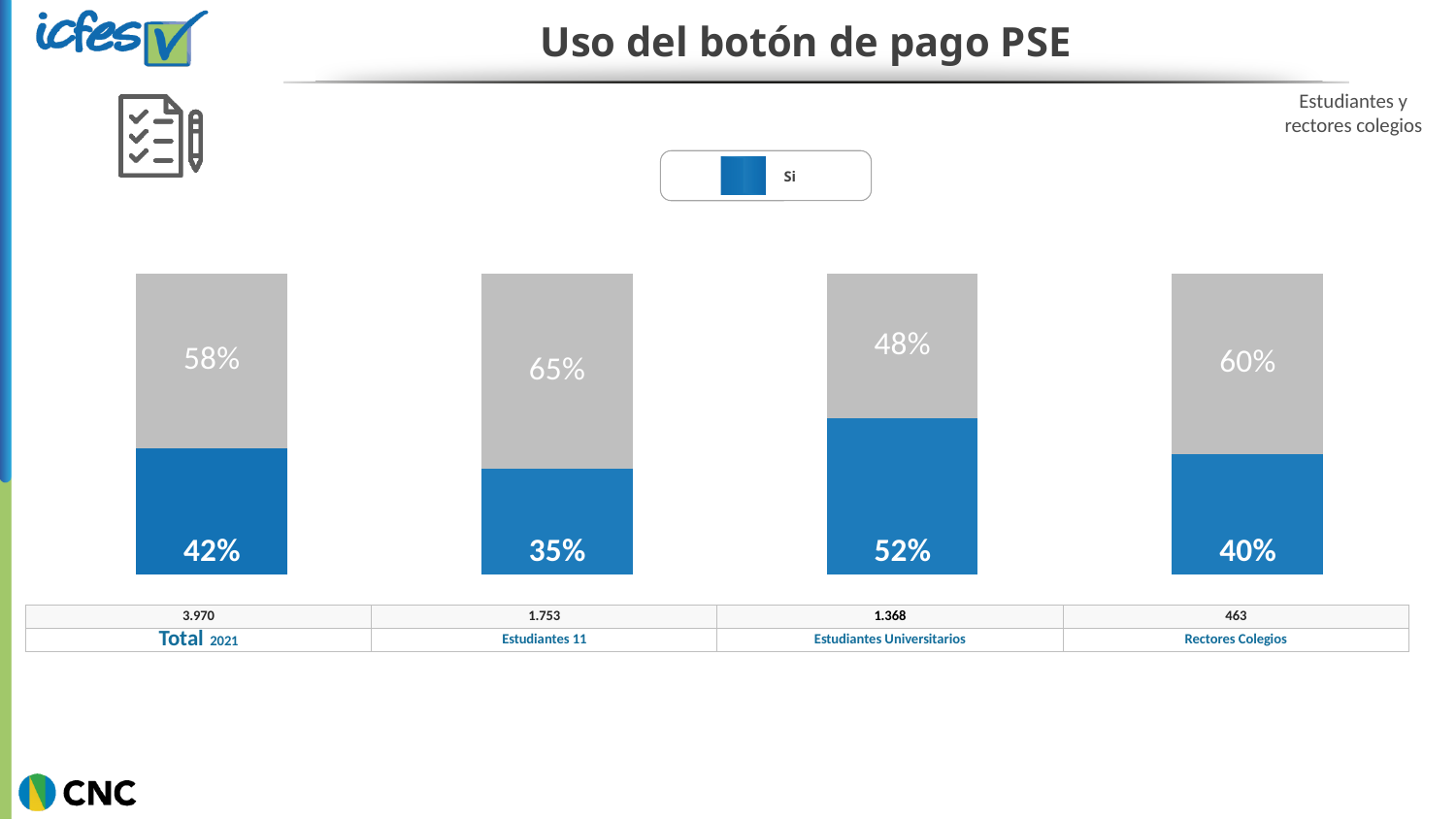
What is the sample size shown for Rectores Colegios? 463 What type of chart is used on this slide? Stacked bar chart How many groups (bars) are shown in the chart? 4 Which group has the lowest "Si" percentage? Estudiantes 11 What is the grey (non-"Si") percentage shown for Rectores Colegios? 60% What is the "Si" percentage for Estudiantes 11? 35% Which has a larger "Si" percentage, Total 2021 or Rectores Colegios? Total 2021 What is the difference in "Si" percentage between Estudiantes Universitarios and Estudiantes 11? 17% What percentage of Estudiantes Universitarios answered "Si" to using the PSE payment button? 52% Which group has the highest "Si" percentage? Estudiantes Universitarios What is the "Si" percentage for the Total 2021 group? 42% What is the title of the chart on this slide? Uso del botón de pago PSE